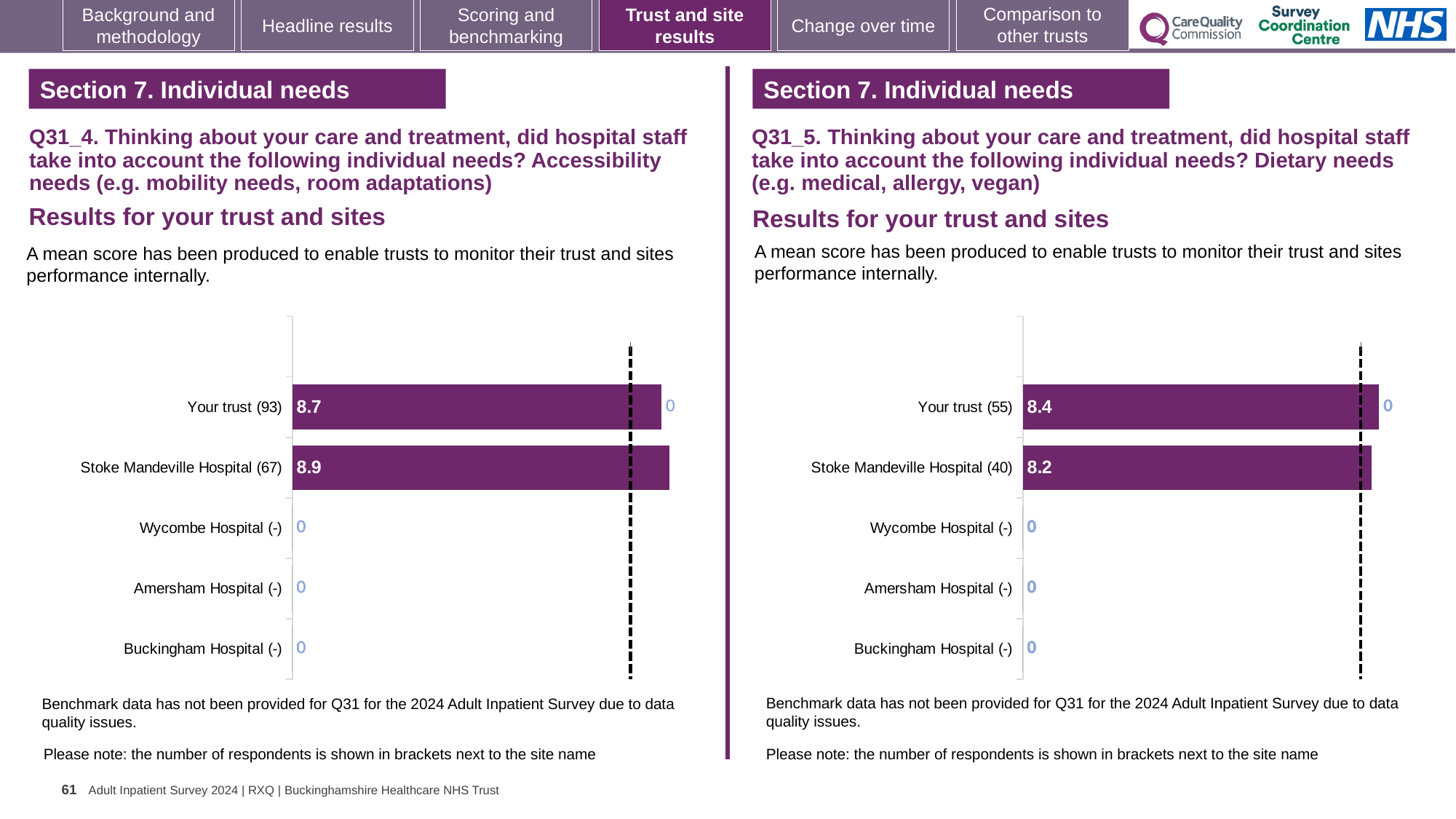
In the Q31_5 chart (Dietary needs) on the right, what is the mean score for Stoke Mandeville Hospital? 8.2 In the Q31_4 chart (Accessibility needs) on the left, what is the mean score for Your trust? 8.7 In the Q31_5 chart on the right, how many respondents are shown in brackets for Stoke Mandeville Hospital? 40 What type of chart is used in the Q31_5 chart on the right? Bar chart In the Q31_5 chart (Dietary needs) on the right, what is the mean score for Your trust? 8.4 In the Q31_4 chart (Accessibility needs) on the left, what is the mean score for Stoke Mandeville Hospital? 8.9 In the Q31_4 chart on the left, how many respondents are shown in brackets for Your trust? 93 How many categories (sites including Your trust) are listed in the Q31_4 chart on the left? 5 In the Q31_4 chart on the left, what is the difference between the Stoke Mandeville Hospital score and the Your trust score? 0.2 In the Q31_5 chart on the right, which is higher: Your trust or Stoke Mandeville Hospital? Your trust In the Q31_4 chart on the left, which is higher: Your trust or Stoke Mandeville Hospital? Stoke Mandeville Hospital In the Q31_5 chart on the right, what is the difference between the Your trust score and the Stoke Mandeville Hospital score? 0.2